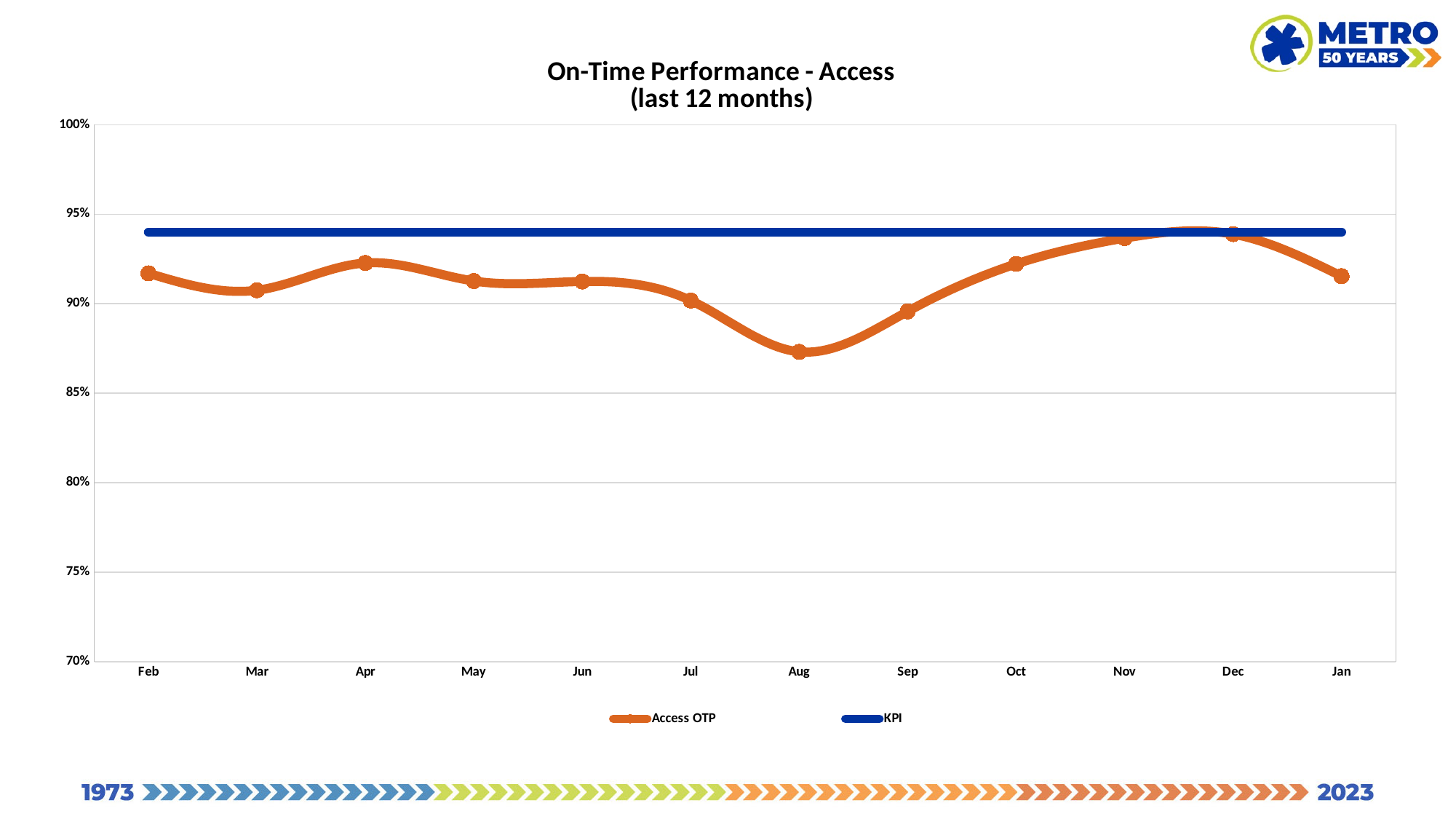
In which month is the Access OTP value lowest? Aug What kind of chart is shown on the slide? line chart Does the Access OTP line rise or fall from Aug to Nov? rise Is the Access OTP value for Nov greater or less than 95%? less What is the title of the chart? On-Time Performance - Access (last 12 months) Is the Access OTP value for Feb greater or less than 90%? greater How many series does the legend list? 2 How many months are plotted along the x axis? 12 What are the two series named in the legend? Access OTP and KPI Which month has the higher Access OTP value, Jul or Oct? Oct Is the Access OTP value for Aug greater or less than 90%? less Which month has the higher Access OTP value, Mar or Apr? Apr